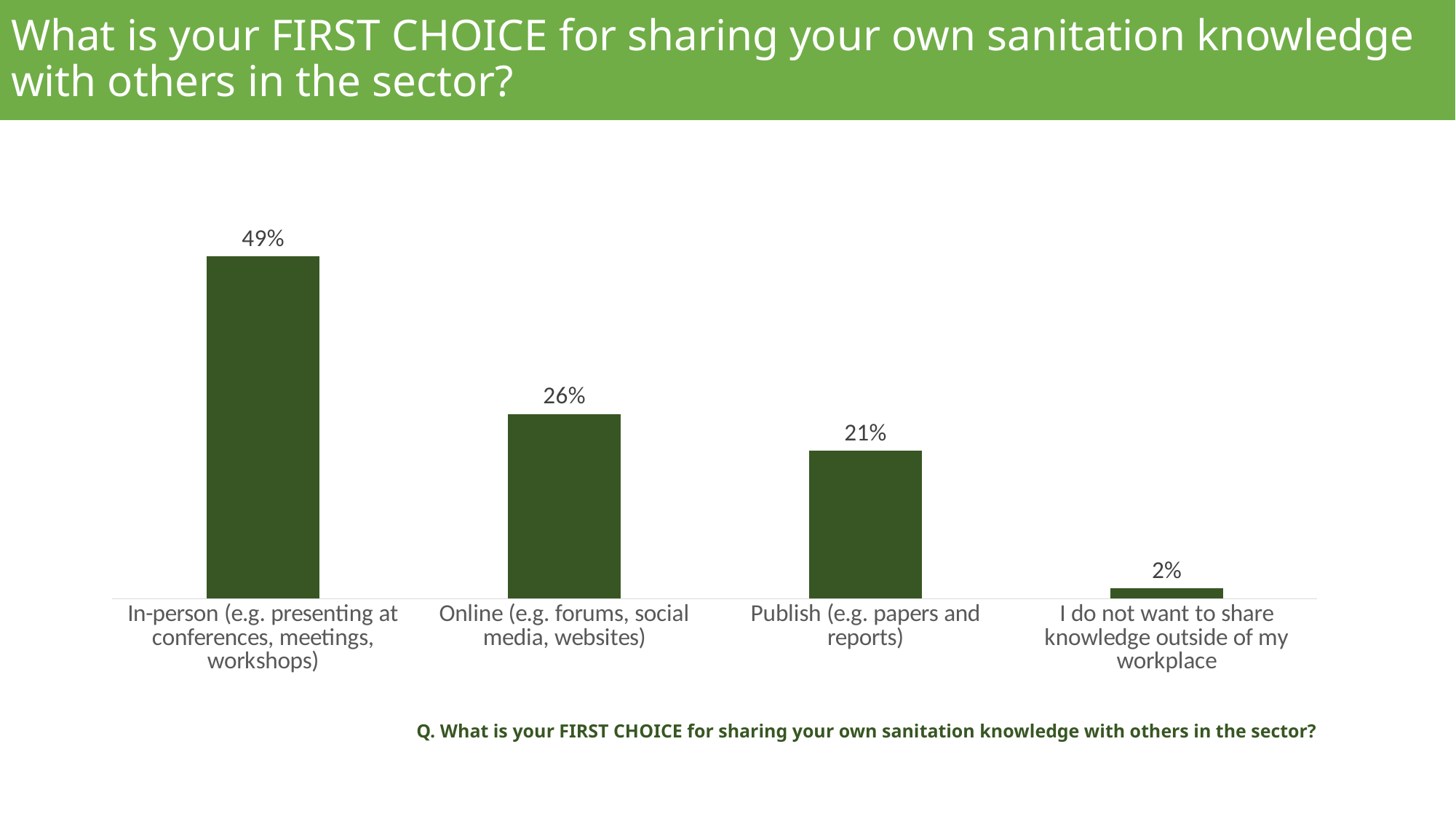
What is the difference between the Online value and the Publish value? 5% Do the values rise or fall from left to right across the categories? Fall What is the value for Online (e.g. forums, social media, websites)? 26% Which category has the highest value? In-person (e.g. presenting at conferences, meetings, workshops) Which is larger, the value for Online or the value for Publish? Online (e.g. forums, social media, websites) What is the value for Publish (e.g. papers and reports)? 21% How many categories are shown in the chart? 4 What percentage of respondents chose In-person (e.g. presenting at conferences, meetings, workshops) as their first choice? 49% What kind of chart is shown on the slide? Bar chart Which category has the lowest value? I do not want to share knowledge outside of my workplace What is the difference between the In-person value and the Online value? 23% What percentage said they do not want to share knowledge outside of their workplace? 2%